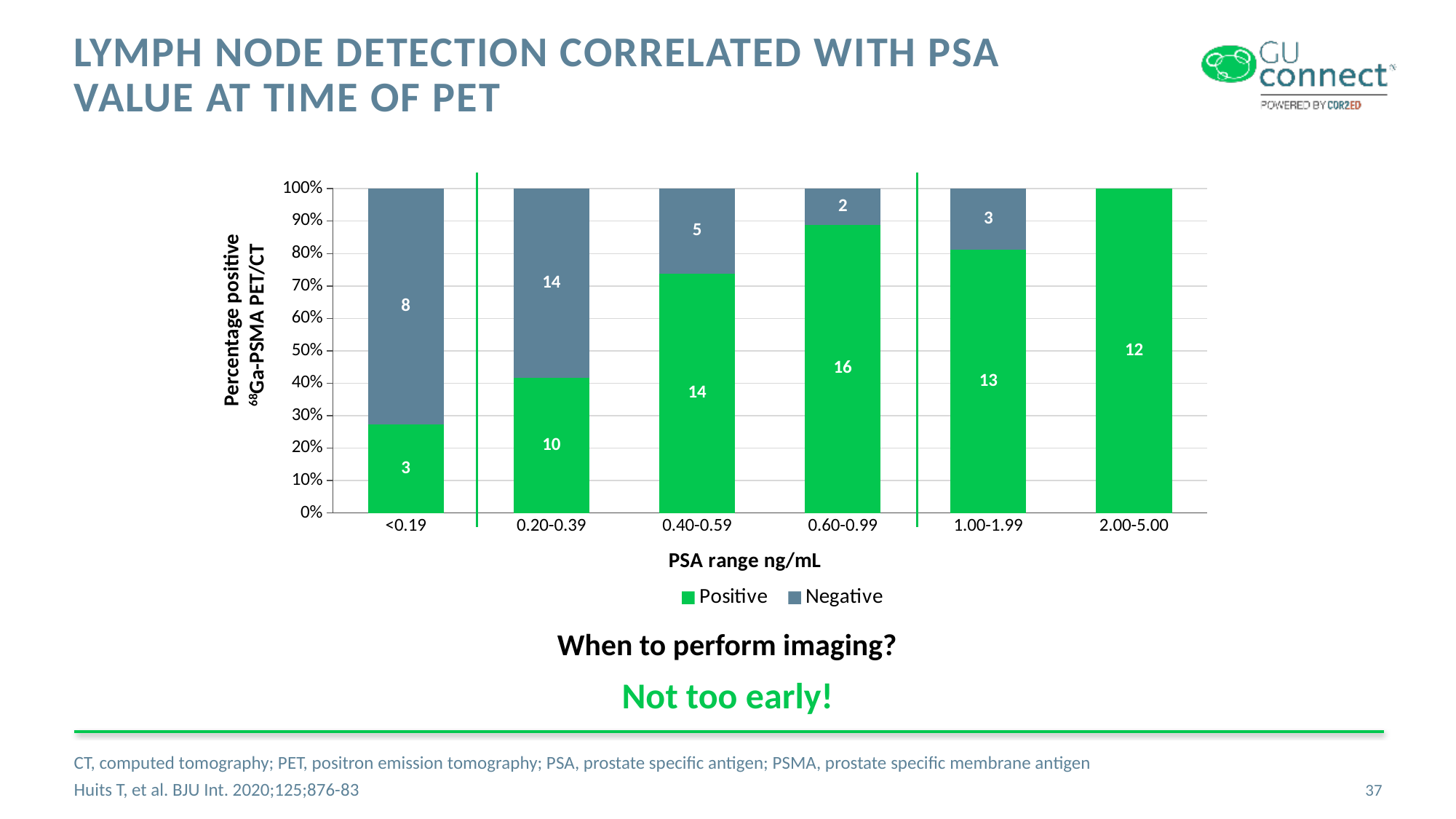
What is the Negative count labelled for the 0.20-0.39 PSA range? 14 What is the Positive count labelled for the 0.60-0.99 PSA range? 16 What kind of chart is shown on the slide? Stacked bar chart How many PSA range categories are shown on the x axis? 6 What is the Positive count labelled for the <0.19 PSA range? 3 Is the Positive percentage for the 0.60-0.99 PSA range greater or less than 80%? greater Which PSA range has the highest labelled Negative count? 0.20-0.39 Which PSA range has the highest labelled Positive count? 0.60-0.99 How many series does the legend list? 2 What is the difference between the Positive counts for the 0.60-0.99 and <0.19 PSA ranges? 13 What is the total number of patients (Positive plus Negative) in the 0.20-0.39 PSA range? 24 In the 0.20-0.39 PSA range, which is larger, the Positive count or the Negative count? Negative